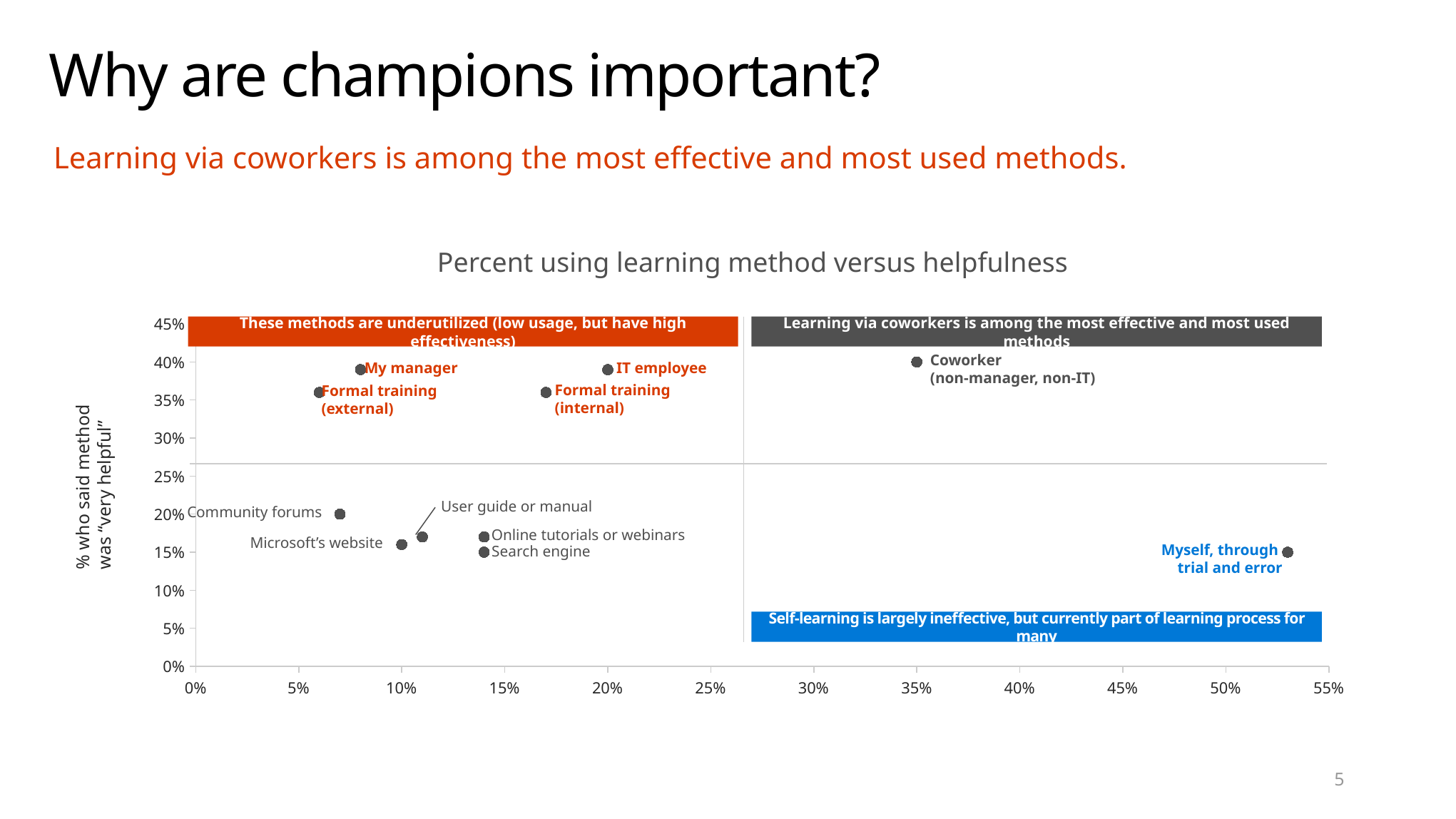
Which learning method has the highest percent usage (furthest right on the x axis)? Myself, through trial and error Is the percent usage for "Coworker (non-manager, non-IT)" greater or less than 30%? greater Is the percent usage for "Myself, through trial and error" greater or less than 50%? greater Which has a higher helpfulness value: "Formal training (internal)" or "Online tutorials or webinars"? Formal training (internal) Is the helpfulness value for "My manager" greater or less than 35%? greater What kind of chart is shown on the slide? scatter chart Which has a higher percent usage: "IT employee" or "My manager"? IT employee Which has a higher percent usage: "Coworker (non-manager, non-IT)" or "Search engine"? Coworker (non-manager, non-IT) How many learning methods are plotted as points on the chart? 11 What is the title of the chart? Percent using learning method versus helpfulness What is the label on the vertical axis of the chart? % who said method was "very helpful"